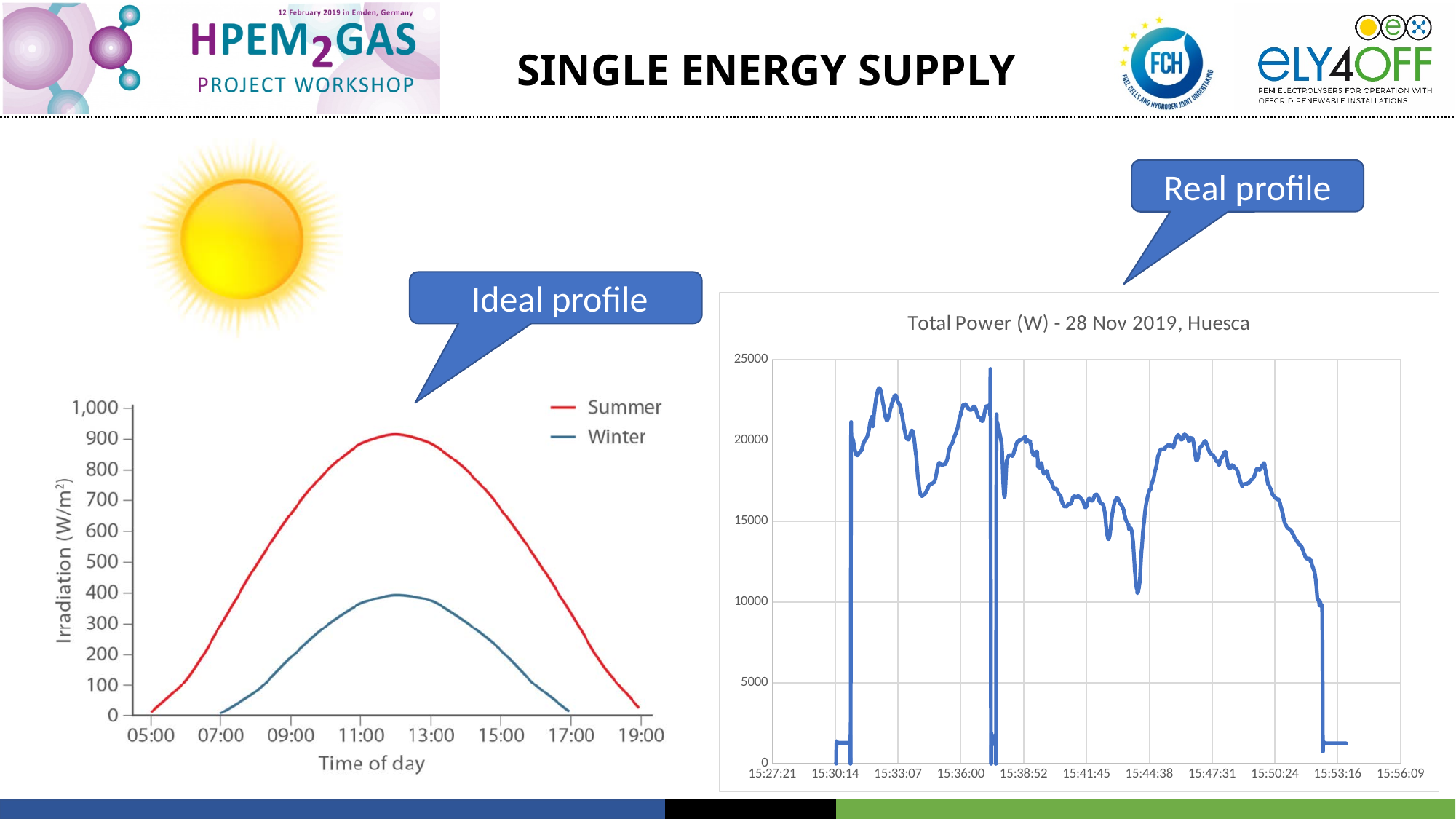
In the 'Total Power (W) - 28 Nov 2019, Huesca' chart, does the power rise or fall between 15:50:24 and 15:53:16? fall How many series does the legend of the 'Ideal profile' chart on the left list? 2 In the 'Ideal profile' chart on the left, does the Summer curve rise or fall between 05:00 and 11:00? rise What kind of chart is the 'Ideal profile' chart on the left? line chart What is the title of the chart on the right of the slide? Total Power (W) - 28 Nov 2019, Huesca What kind of chart is the 'Total Power (W) - 28 Nov 2019, Huesca' chart? line chart In the 'Ideal profile' chart on the left, is the peak value of the Winter curve greater or less than 500? less In the 'Total Power (W) - 28 Nov 2019, Huesca' chart, is the highest value reached greater or less than 20000? greater In the 'Ideal profile' chart on the left, is the peak value of the Summer curve greater or less than 800? greater What is the y-axis label of the 'Ideal profile' chart on the left? Irradiation (W/m²) In the 'Ideal profile' chart on the left, which series reaches the higher peak irradiation, Summer or Winter? Summer